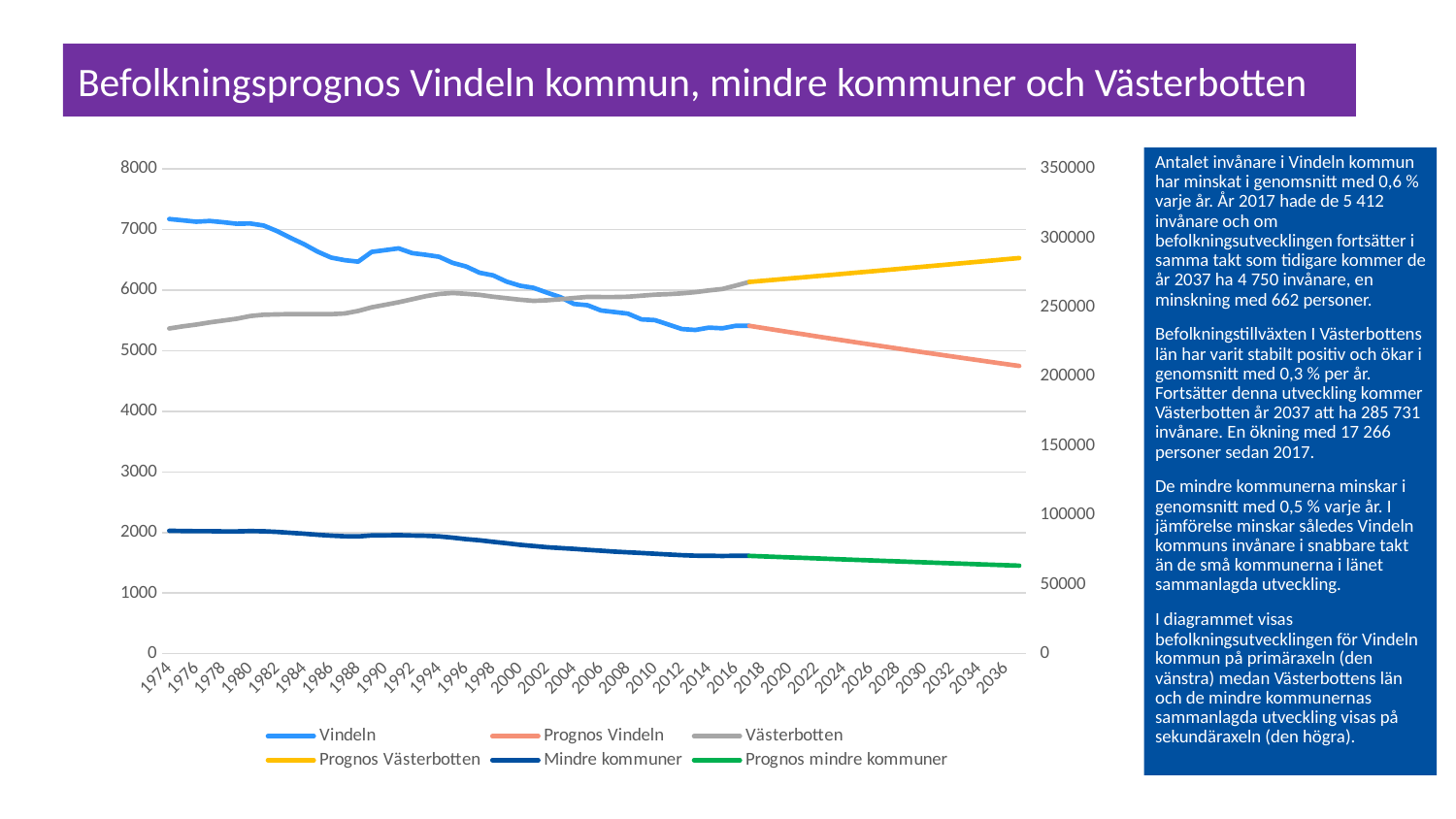
What kind of chart is shown on the slide? Line chart What is the title of the slide containing the chart? Befolkningsprognos Vindeln kommun, mindre kommuner och Västerbotten How many series does the chart legend list? 6 Does the Prognos Västerbotten series rise or fall between 2018 and 2036? Rise On the right axis, is the value for Prognos Västerbotten in 2036 greater or less than 250000? greater Does the Mindre kommuner series rise or fall between 1974 and 2016? Fall On the left axis, is the value for Vindeln in 1974 greater or less than 7000? greater Which is larger: the Vindeln value in 1974 or the Vindeln value in 2016? 1974 On the right axis, is the value for Mindre kommuner in 1974 greater or less than 100000? less Which colour is used for the Prognos Västerbotten series? Yellow Does the Vindeln series rise or fall between 1974 and 2016? Fall